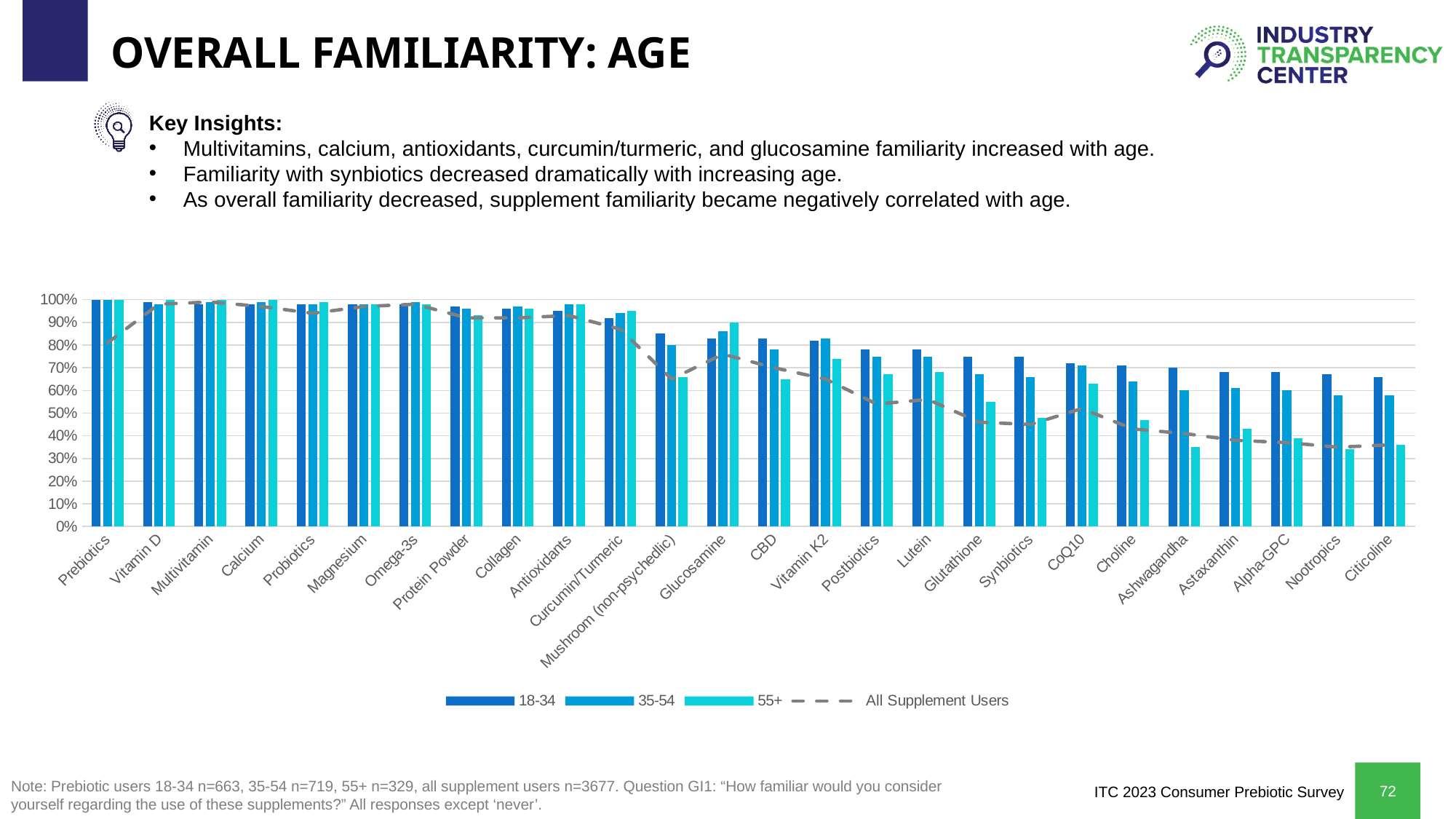
What kind of chart is shown on the slide? Combination bar and line chart For Synbiotics, which is larger: the 18-34 value or the 55+ value? 18-34 For Glucosamine, which is larger: the 18-34 value or the 55+ value? 55+ Which series is drawn as a dashed line rather than bars? All Supplement Users Is the value for Synbiotics in the 55+ series greater or less than 50%? less How many series does the chart legend list? 4 Do the 18-34 values generally rise or fall moving from left to right along the x axis? Fall How many supplement categories are shown along the x axis? 26 Which supplement category appears first on the x axis? Prebiotics Is the value for Glucosamine in the 55+ series greater or less than 80%? greater Is the value for Citicoline in the 18-34 series greater or less than 60%? greater